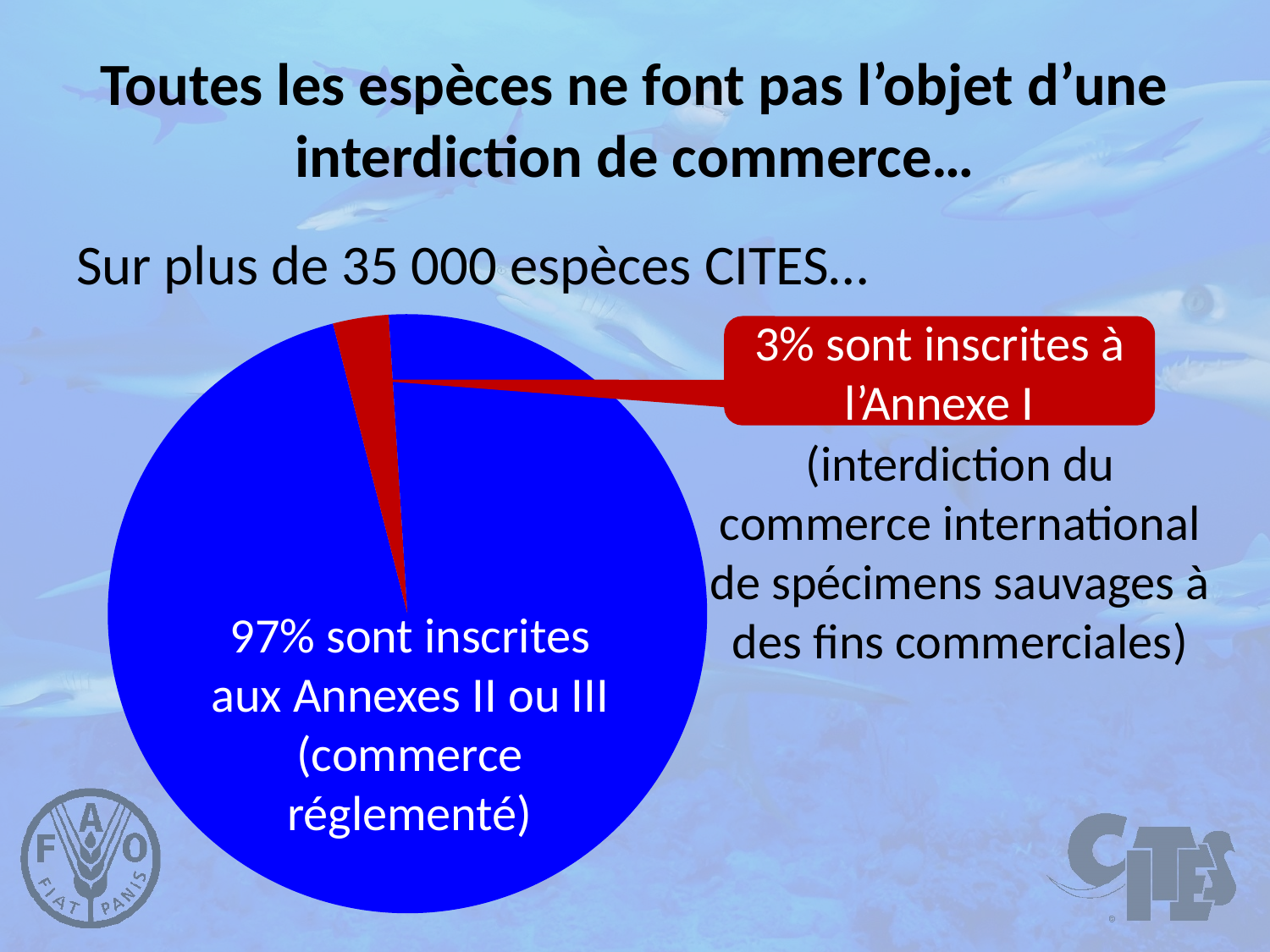
What share of CITES species are listed in Annexes II or III according to the pie chart? 97% What kind of chart is shown on the slide? pie chart Which slice of the pie chart is the smallest? Annexe I What is the difference in percentage points between the Annexes II or III slice and the Annex I slice? 94 How many slices does the pie chart have? 2 What share of CITES species are listed in Annex I according to the pie chart? 3% What is the total of the two percentages shown on the pie chart? 100% Which slice of the pie chart is the largest? Annexes II ou III (commerce réglementé) Which is larger: the share of species in Annex I or the share in Annexes II or III? Annexes II ou III What colour is the slice representing species listed in Annex I? red What colour is the slice representing species listed in Annexes II or III? blue